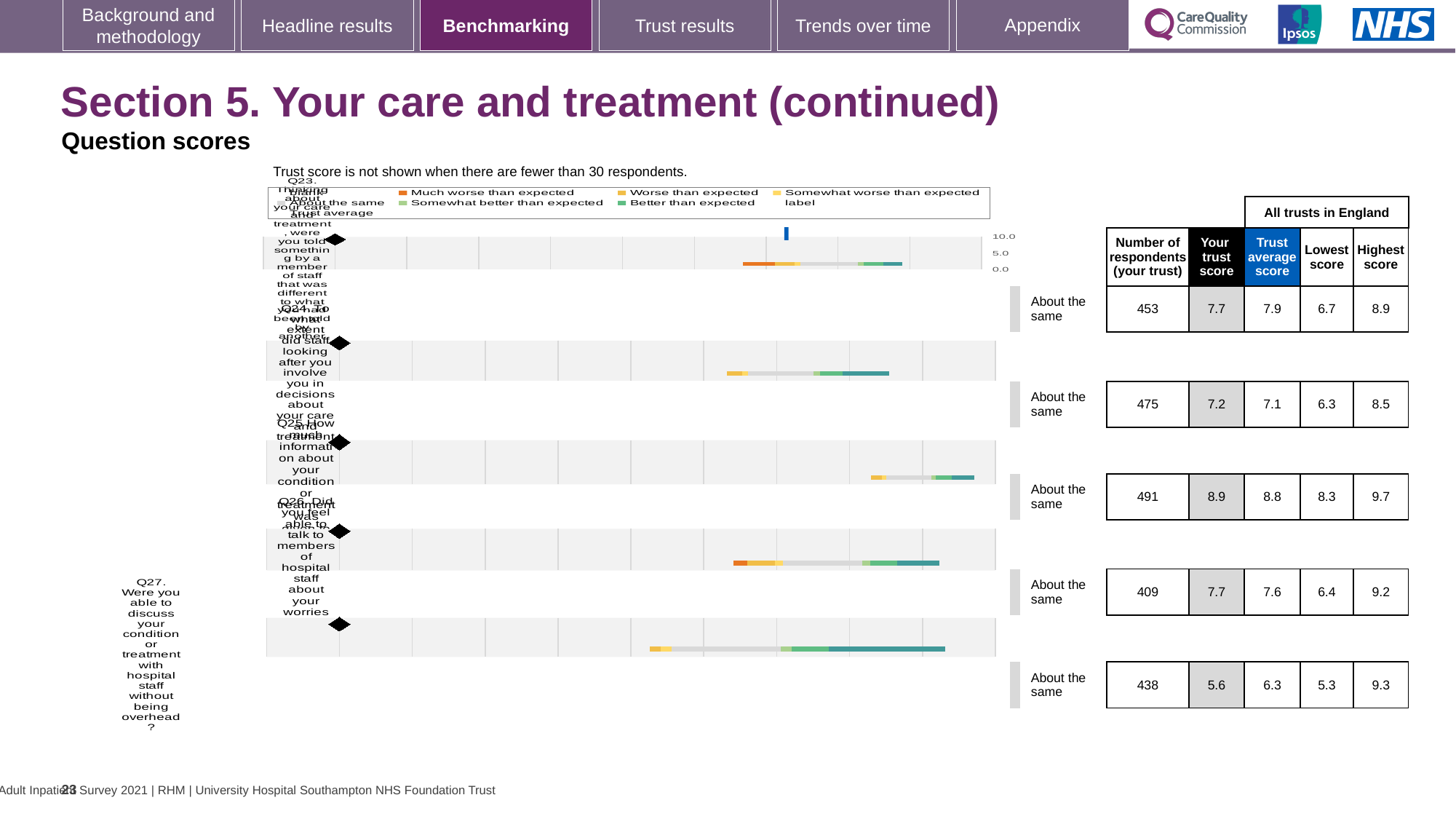
Which question row has the highest 'Your trust score'? The third row (Q25), 8.9 What kind of chart is used to show the question scores? Bar chart Which question row has the lowest 'Your trust score'? Q27, 5.6 For Q27, how much higher is the trust average score than your trust score? 0.7 What benchmark category is shown for every question on this slide? About the same What is the highest score among all trusts in England for the fourth question row (Q26)? 9.2 What is the 'Your trust score' for Q27 (Were you able to discuss your condition or treatment with hospital staff without being overheard?)? 5.6 For the third question row (Q25), what is the difference between the highest score and the lowest score across all trusts in England? 1.4 For the second question row (Q24), which is larger: your trust score or the trust average score? Your trust score (7.2) What is the trust average score for Q27? 6.3 How many question rows are plotted on the chart? 5 How many respondents answered Q27 at this trust? 438